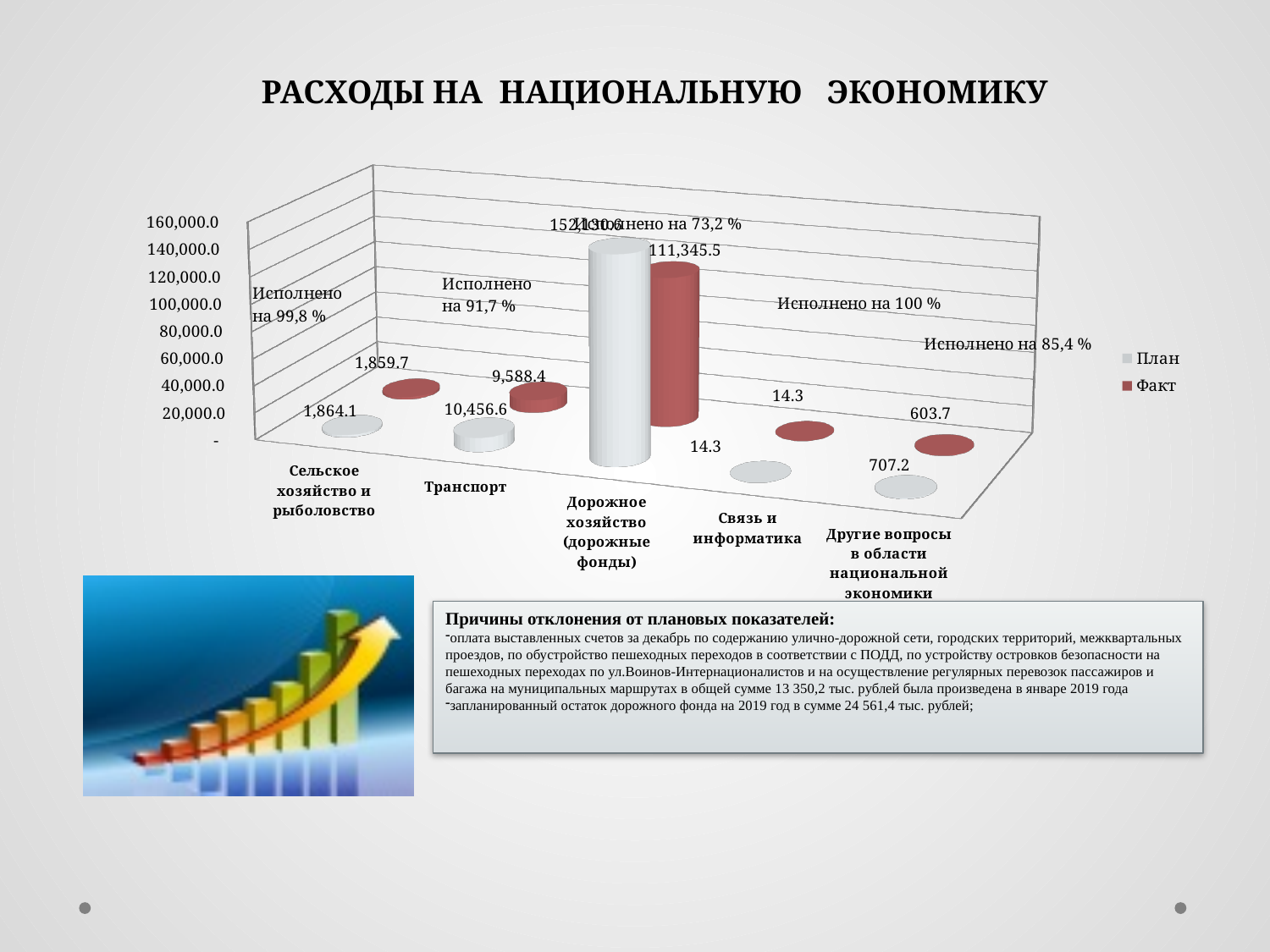
What is the План value for Другие вопросы в области национальной экономики? 707.2 What is the Факт value for Транспорт? 9,588.4 What kind of chart is shown on the slide? bar chart How many series does the legend list? 2 What is the Факт value for Связь и информатика? 14.3 Is the Факт value for Дорожное хозяйство (дорожные фонды) greater or less than 100,000.0? greater Which category has the highest Факт value? Дорожное хозяйство (дорожные фонды) What is the План value for Транспорт? 10,456.6 What is the difference between the План and Факт values for Транспорт? 868.2 How many categories are shown on the x axis? 5 Which category has the lowest План value? Связь и информатика What is the Факт value for Дорожное хозяйство (дорожные фонды)? 111,345.5